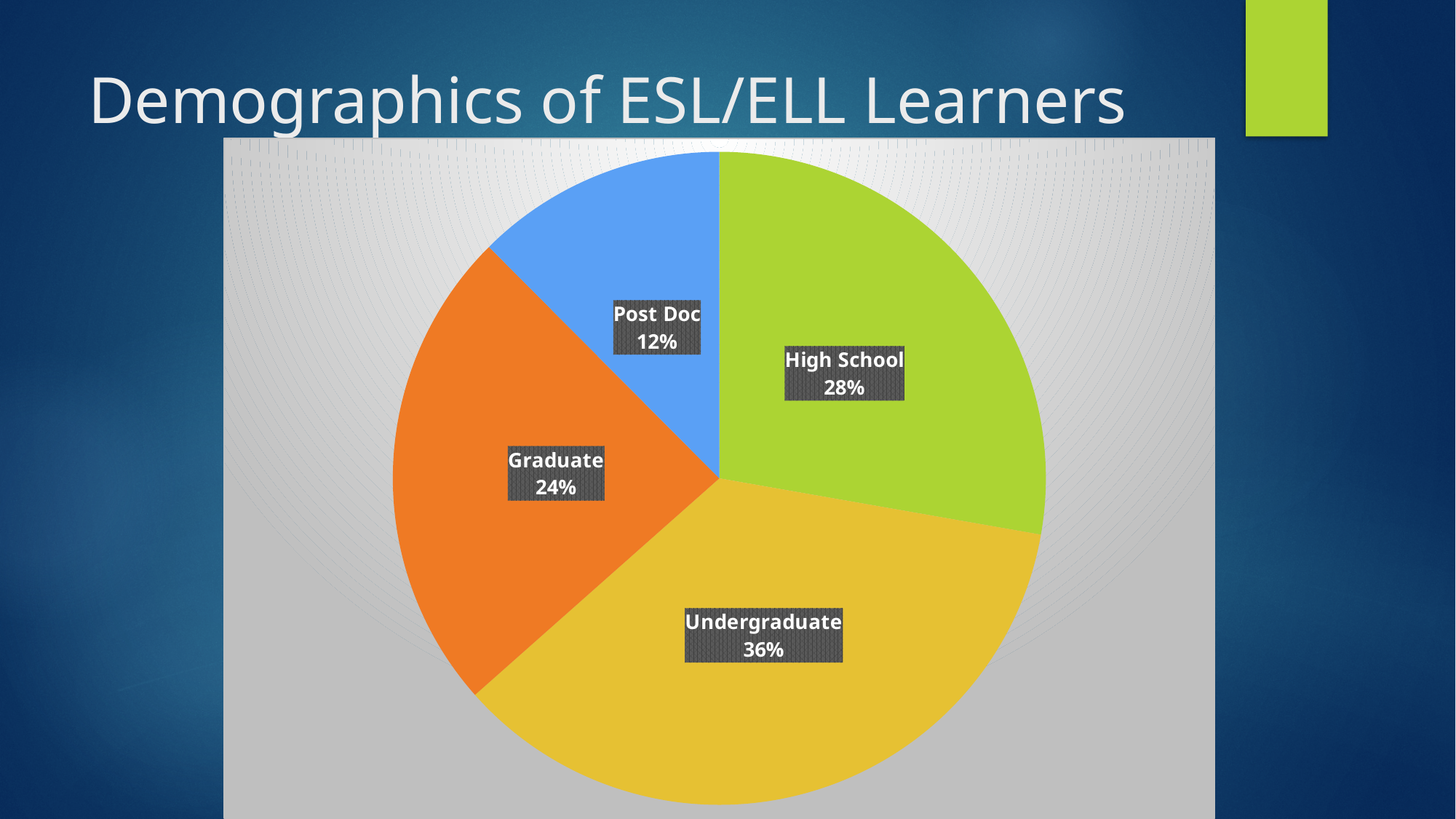
What percentage of ESL/ELL learners are High School students? 28% Which category has the largest share of the pie? Undergraduate What colour is the Undergraduate slice? yellow How many categories are shown in the pie chart? 4 What percentage of ESL/ELL learners are Undergraduate students? 36% What kind of chart is shown on the slide? pie chart What percentage of ESL/ELL learners are Graduate students? 24% What percentage of ESL/ELL learners are Post Doc? 12% Which category has the smallest share of the pie? Post Doc What is the difference in percentage points between Undergraduate and Post Doc? 24 Which is larger, the share for High School or the share for Graduate? High School What is the combined share of Graduate and Post Doc learners? 36%